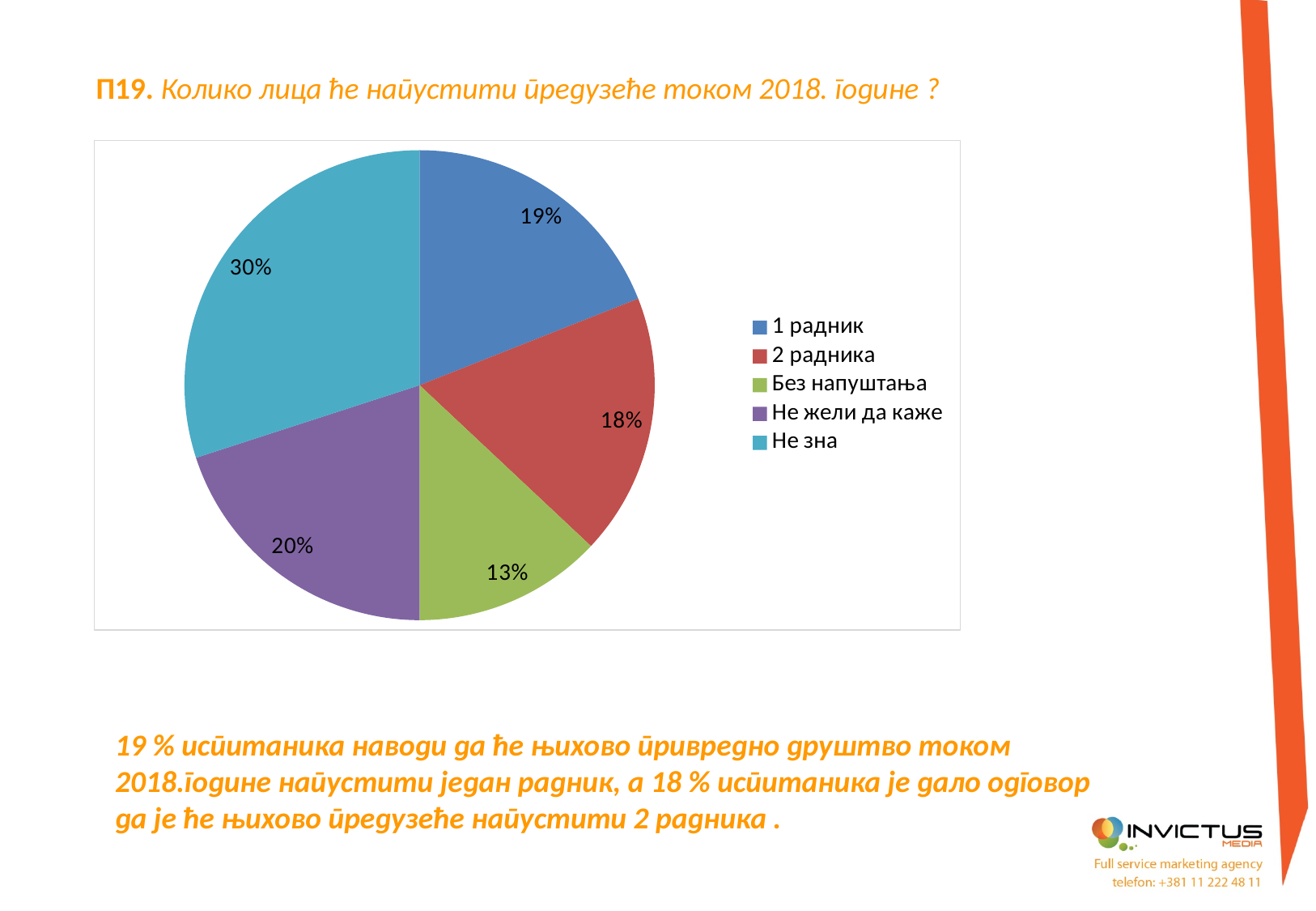
Which colour is used for the "Не зна" slice? Teal (light blue) Which is larger: the slice for "Не жели да каже" or the slice for "2 радника"? Не жели да каже What percentage is shown for "Не жели да каже"? 20% What percentage is shown for "Без напуштања"? 13% How many slices does the pie chart have? 5 Which category has the largest slice of the pie? Не зна What share of the pie does the "Не зна" slice represent? 30% What type of chart is shown on the slide? Pie chart What percentage is shown for "1 радник"? 19% What is the difference in percentage points between "Не зна" and "Без напуштања"? 17 What is the combined share of "1 радник" and "2 радника"? 37% Which category has the smallest slice of the pie? Без напуштања